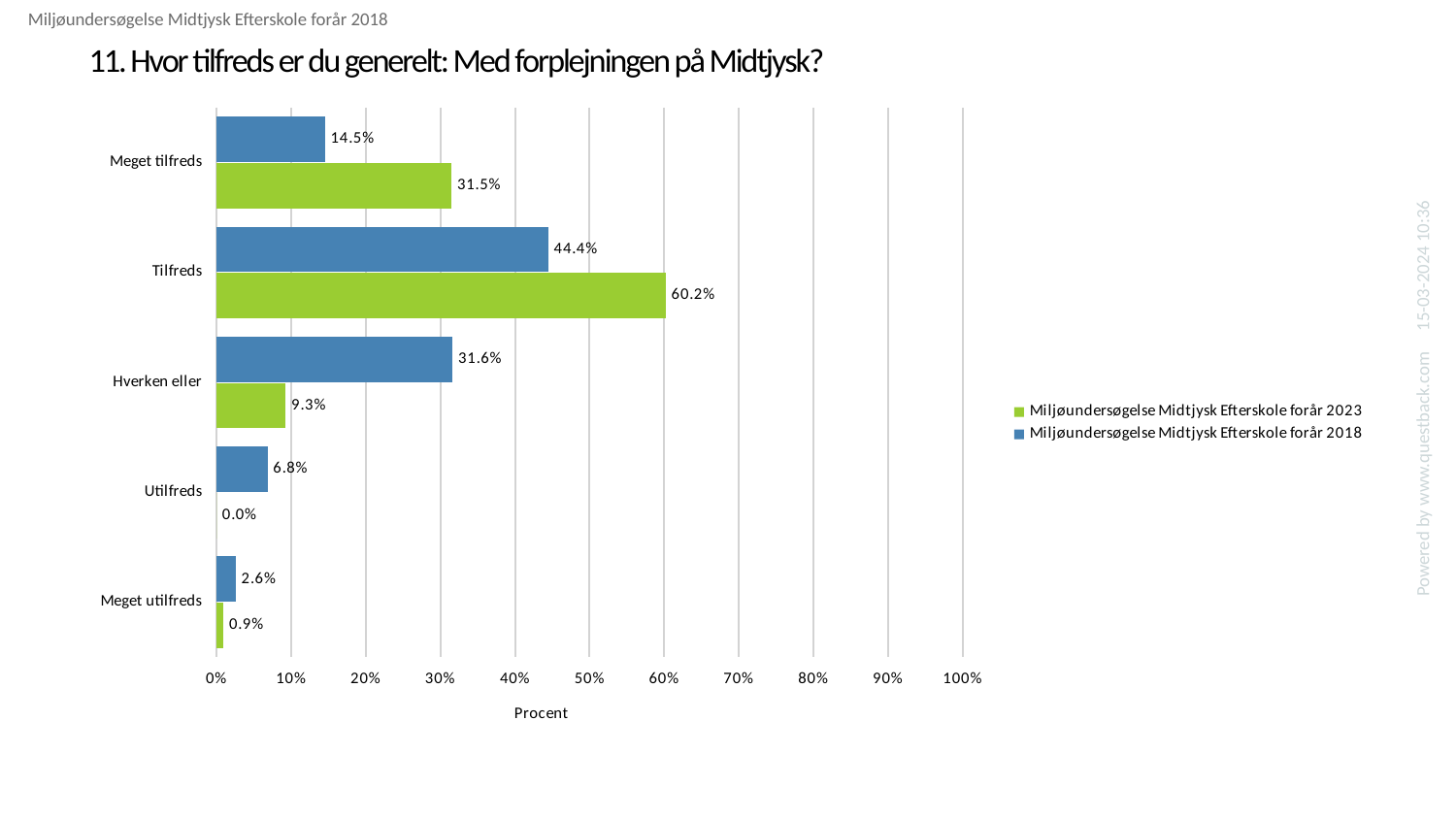
What is the value for "Hverken eller" in the 2018 series (Miljøundersøgelse Midtjysk Efterskole forår 2018)? 31.6% For "Hverken eller", which series has the larger value, 2018 or 2023? 2018 What is the value for "Utilfreds" in the 2023 series? 0.0% How many categories are shown on the chart? 5 What is the difference between the 2023 and 2018 values for "Meget tilfreds"? 17.0% Which category has the highest value in the 2018 series? Tilfreds What kind of chart is shown on the slide? Bar chart How many series does the legend list? 2 Is the 2023 value for "Tilfreds" greater or less than 50%? greater What is the label of the horizontal axis? Procent Which category has the lowest value in the 2023 series? Utilfreds What is the value for "Tilfreds" in the 2023 series (Miljøundersøgelse Midtjysk Efterskole forår 2023)? 60.2%